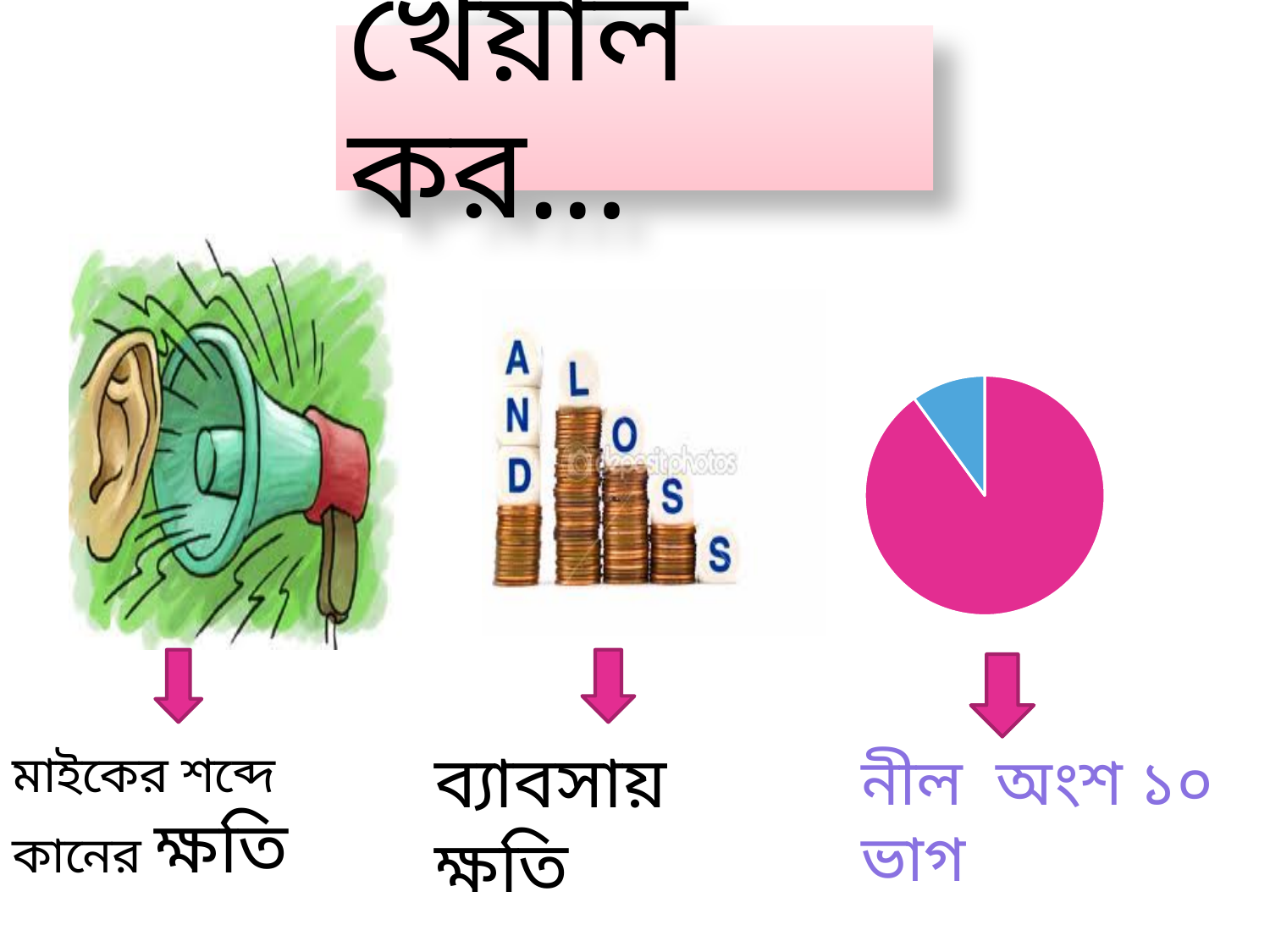
How many slices does the pie chart on the right of the slide have? 2 Does the pie chart on the right of the slide have a legend? No What kind of chart is shown on the right side of the slide? pie chart In the pie chart on the right of the slide, which colour is the smallest slice? blue According to the caption under the pie chart, what share does the blue slice represent? ১০ ভাগ What two colours are used for the slices of the pie chart on the right of the slide? blue and magenta In the pie chart on the right of the slide, which colour is the largest slice? magenta In the pie chart on the right of the slide, which slice is larger, the blue one or the magenta one? magenta